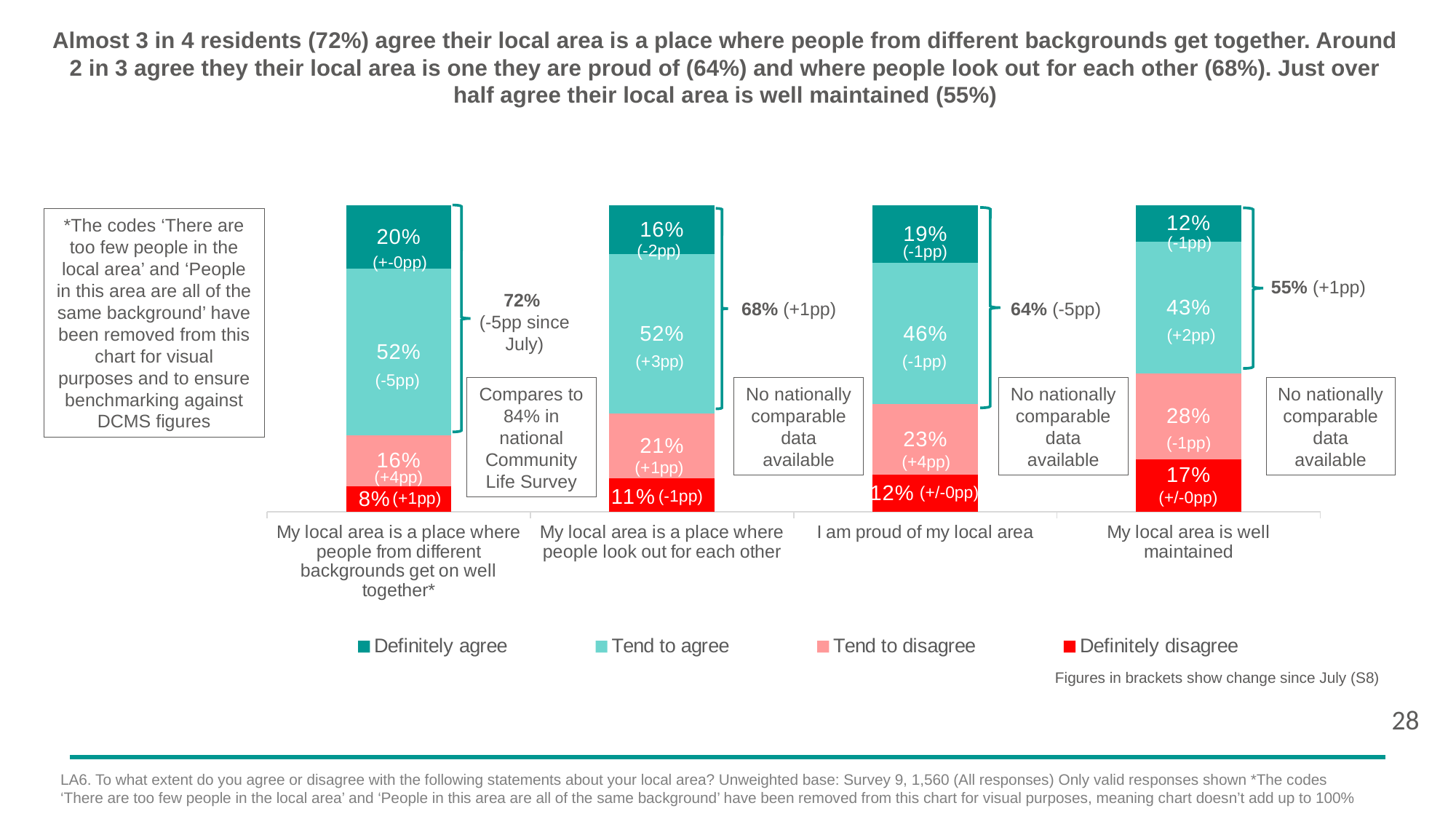
How many series does the legend list? 4 How many statements (categories) are shown on the x axis of the chart? 4 Which has a larger 'Tend to agree' value: 'I am proud of my local area' or 'My local area is well maintained'? I am proud of my local area What is the difference in 'Tend to disagree' between 'My local area is well maintained' and 'My local area is a place where people from different backgrounds get on well together'? 12 percentage points What colour represents 'Definitely disagree' in the legend? Red What kind of chart is shown on the slide? Stacked bar chart Which statement has the highest 'Definitely disagree' percentage? My local area is well maintained What is the 'Tend to agree' value for 'My local area is a place where people look out for each other'? 52% What is the 'Definitely disagree' value for 'My local area is well maintained'? 17% Which statement has the lowest 'Definitely agree' percentage? My local area is well maintained What percentage of residents 'Definitely agree' that they are proud of their local area? 19% What is the combined agree total (Definitely agree plus Tend to agree) shown for 'My local area is well maintained'? 55%